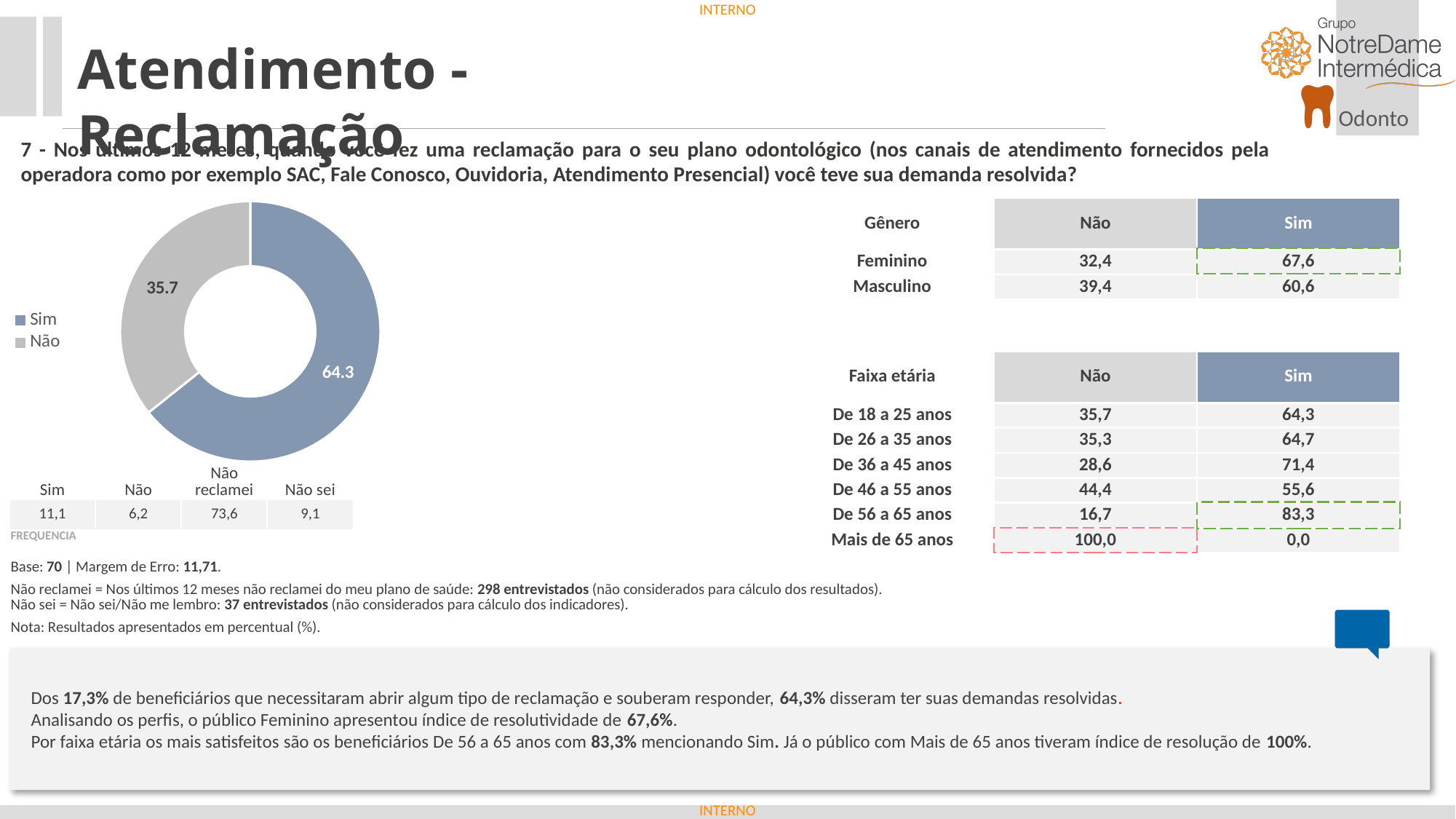
Which category has the smallest slice in the donut chart? Não How many entries does the legend of the donut chart list? 2 How many slices does the donut chart have? 2 What colour is the Sim slice in the donut chart? blue What value is shown for the Não slice of the donut chart? 35.7 In the donut chart, which is larger, Sim or Não? Sim Is the value for Sim in the donut chart greater or less than 50? greater What share of the donut chart does the Não slice represent? 35.7 What value is shown for the Sim slice of the donut chart? 64.3 What type of chart is shown on the left of the slide? donut chart What is the difference between the Sim and Não values in the donut chart? 28.6 Which category has the largest slice in the donut chart? Sim